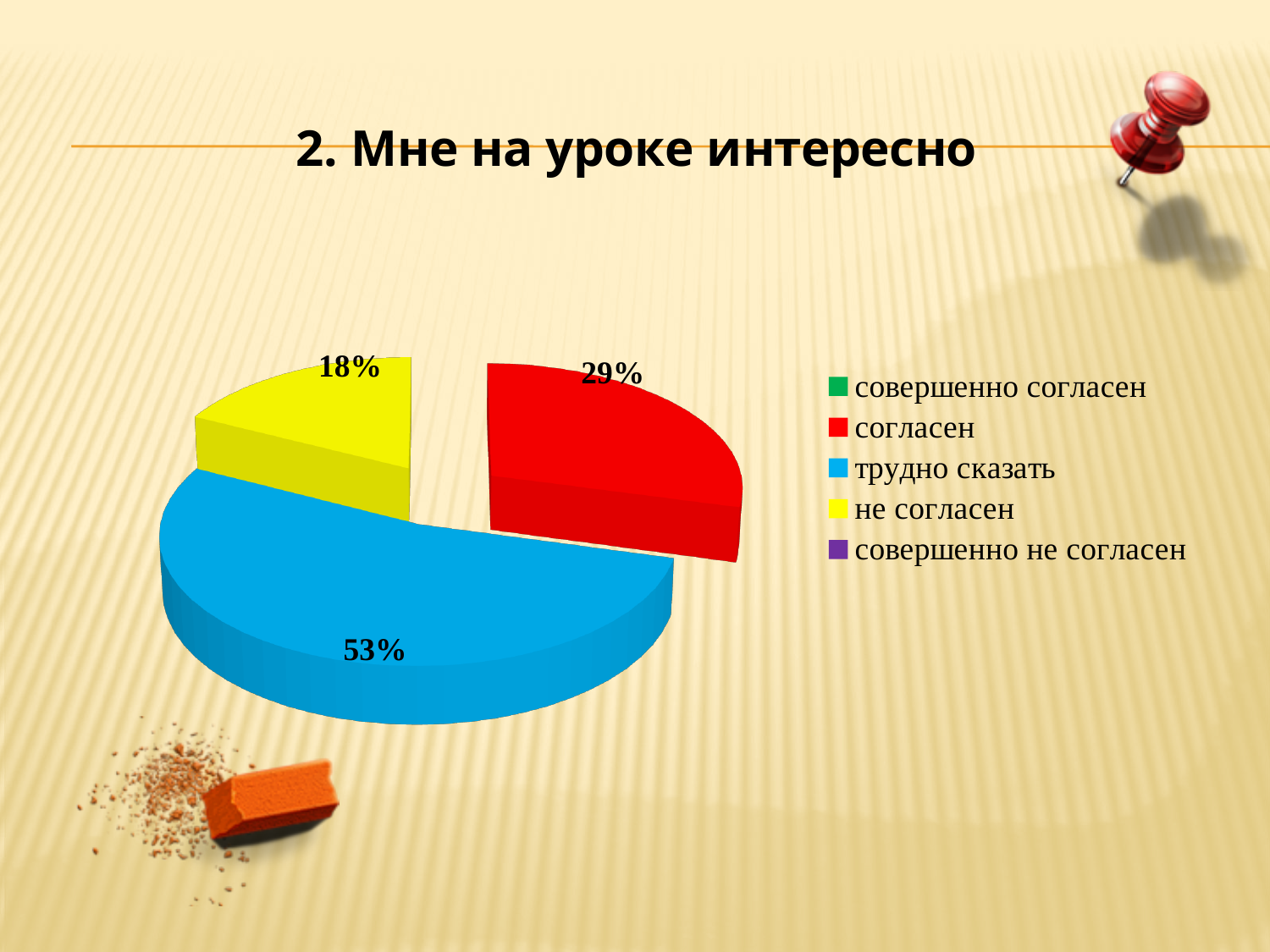
What percentage is shown for "согласен"? 29% Which is larger, the share for "согласен" or the share for "не согласен"? согласен What colour represents "не согласен" in the chart? yellow What kind of chart is shown on the slide? pie chart Which category has the largest slice of the pie? трудно сказать What is the difference in percentage points between "трудно сказать" and "согласен"? 24 How many slices with percentage labels are visible in the pie? 3 How many entries does the legend list? 5 What is the title of the chart on the slide? 2. Мне на уроке интересно What percentage is shown for "трудно сказать"? 53% Which of the labelled slices is the smallest? не согласен What percentage is shown for "не согласен"? 18%